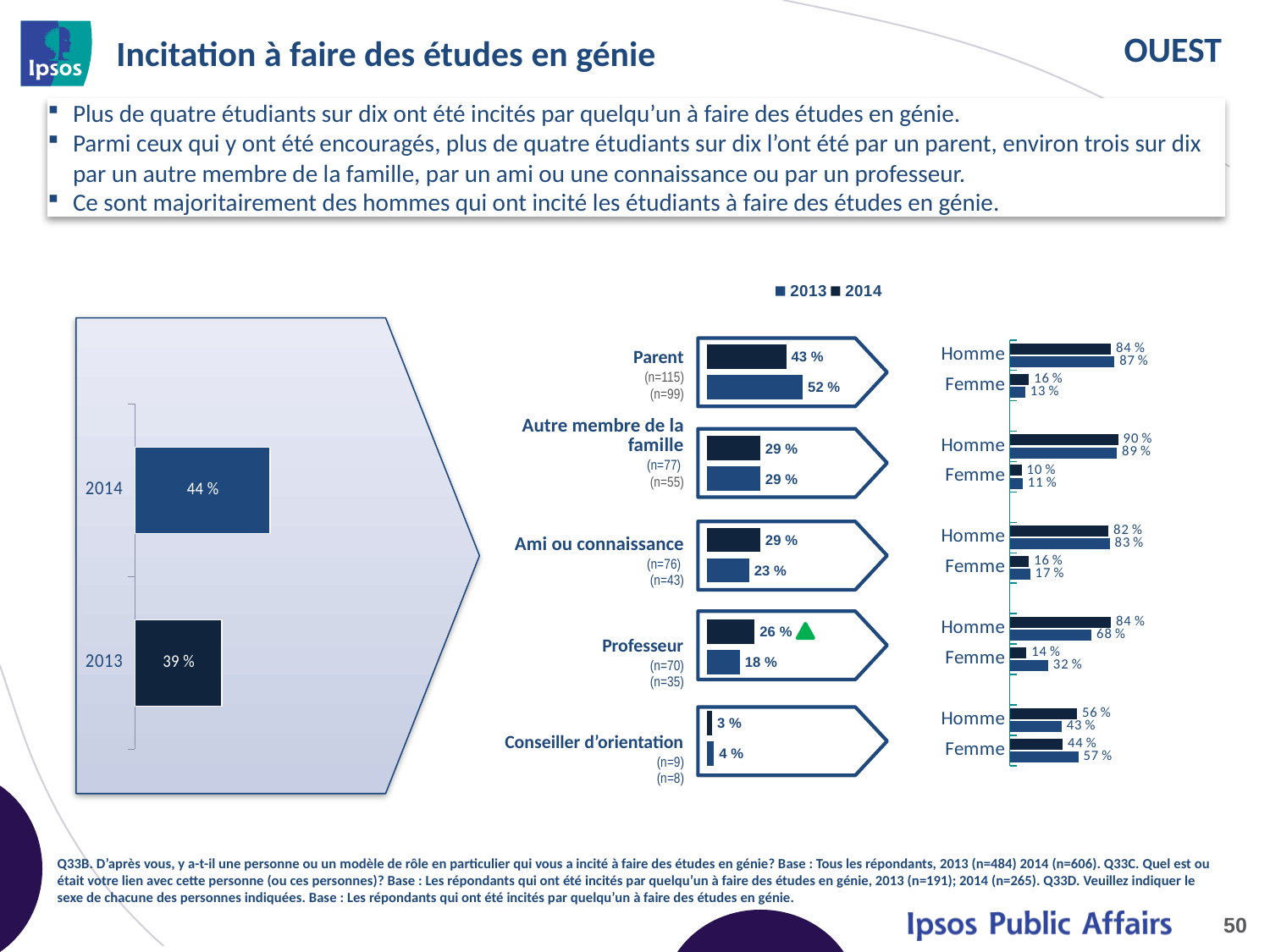
How many categories are shown in the middle chart? 5 In the right chart, what is the 2014 value for Femme under Professeur? 14 % In the middle chart, what is the 2014 value for Parent? 43 % In the middle chart, is the 2013 value for Ami ou connaissance larger or smaller than its 2014 value? smaller In the middle chart, which category has the highest 2013 value? Parent In the middle chart, what is the 2013 value for Professeur? 18 % How many series does the legend list? 2 In the left chart, what is the value for 2013? 39 % In the right chart, what is the difference between the 2013 and 2014 Homme values for Conseiller d'orientation? 13 % In the left chart, what is the value for 2014? 44 % In the left chart, what is the difference between the 2014 and 2013 values? 5 % In the middle chart, which category has the lowest 2014 value? Conseiller d'orientation